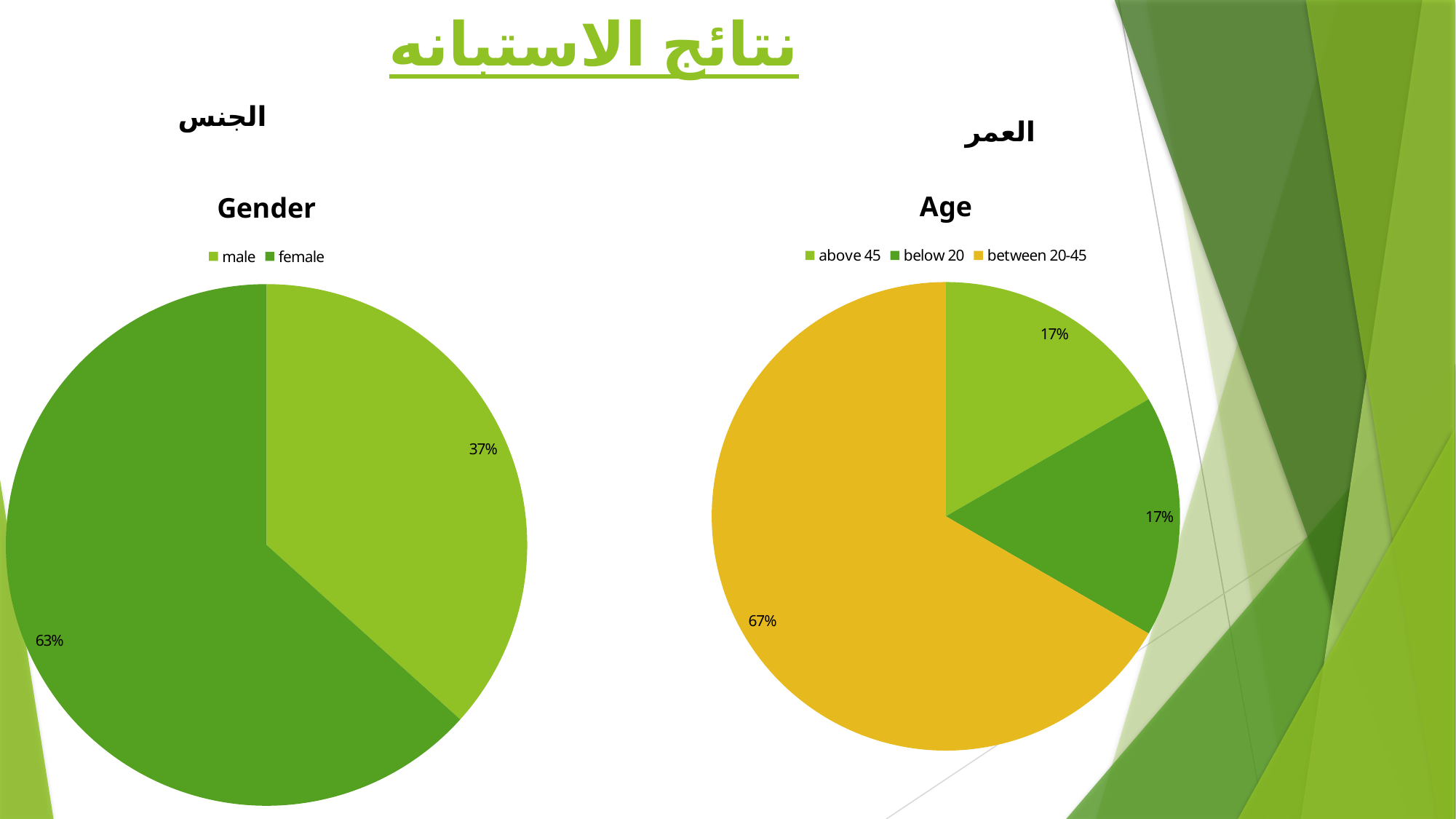
What type of chart is the Gender chart? pie chart In the Gender chart, what percentage is female? 63% In the Age chart, what colour is the between 20-45 slice? yellow In the Gender chart, how many categories does the legend list? 2 In the Age chart, what percentage is between 20-45? 67% In the Age chart, which category has the largest share? between 20-45 In the Gender chart, which category has the larger share? female In the Gender chart, what is the difference between the female and male shares? 26% In the Age chart, what is the difference between the between 20-45 share and the below 20 share? 50% In the Age chart, what percentage is above 45? 17% In the Age chart, how many categories does the legend list? 3 In the Gender chart, what percentage is male? 37%